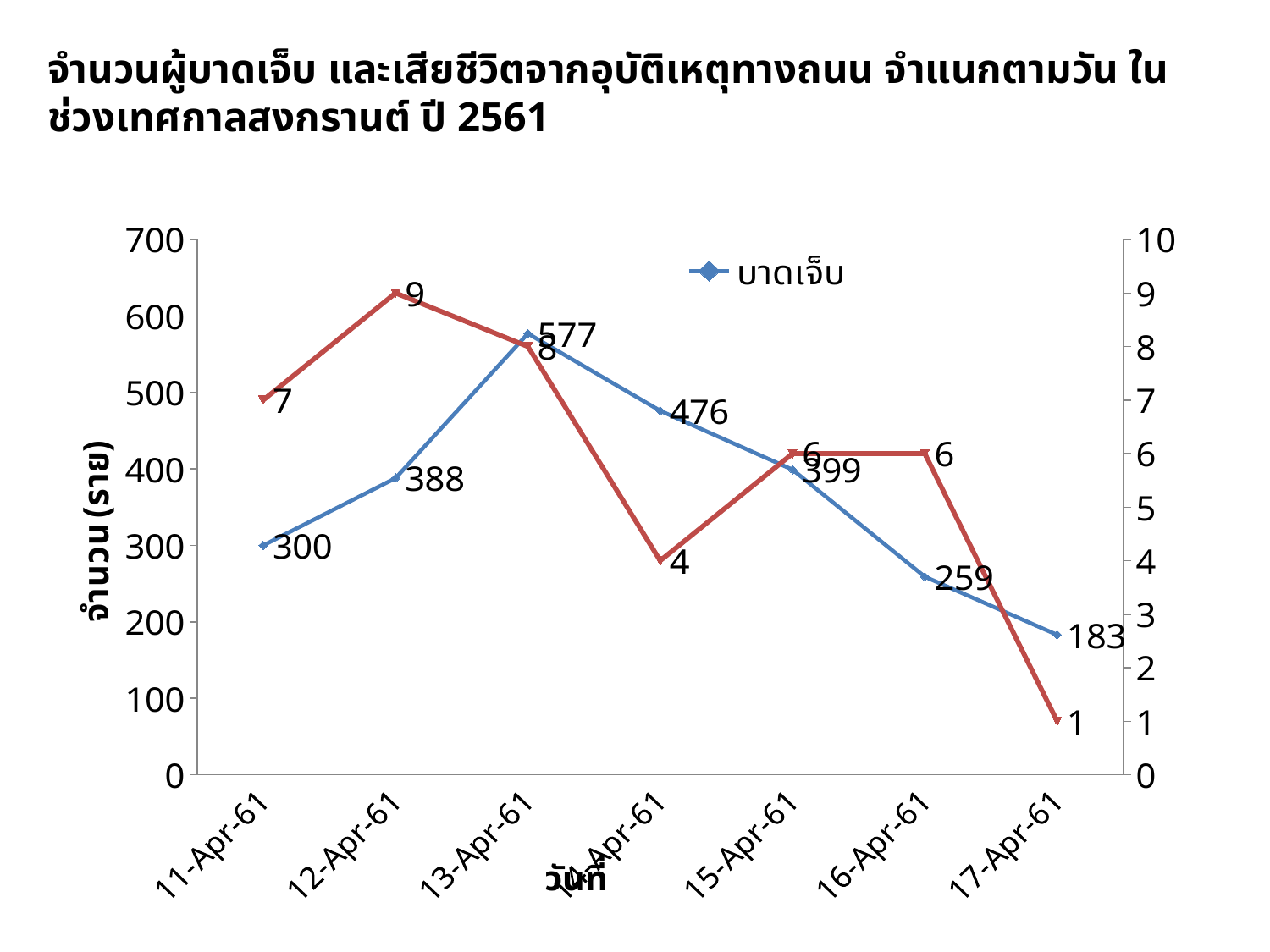
What is the value of บาดเจ็บ on 17-Apr-61? 183 On which date is บาดเจ็บ highest? 13-Apr-61 Which is larger, บาดเจ็บ on 12-Apr-61 or on 15-Apr-61? 15-Apr-61 What is the value of บาดเจ็บ on 13-Apr-61? 577 How many series does the legend list? 1 On which date is บาดเจ็บ lowest? 17-Apr-61 Does บาดเจ็บ rise or fall from 13-Apr-61 to 17-Apr-61? fall How many dates are plotted on the x axis? 7 What is the value of บาดเจ็บ on 11-Apr-61? 300 What is the difference between บาดเจ็บ on 13-Apr-61 and on 14-Apr-61? 101 What type of chart is shown on the slide? line chart What is the label of the left vertical axis? จำนวน (ราย)